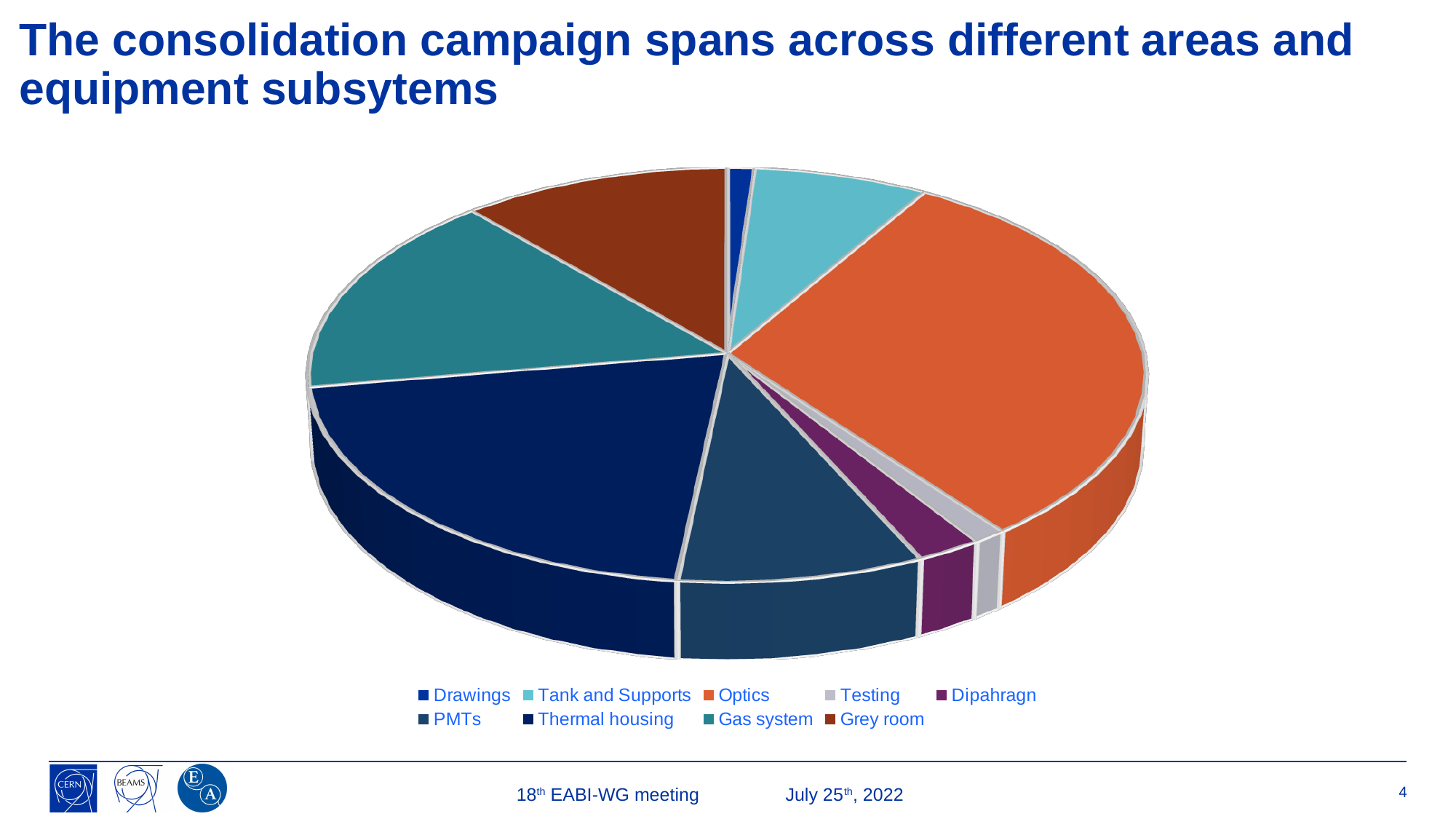
Which slice is larger, Thermal housing or PMTs? Thermal housing Which slice is larger, Optics or Grey room? Optics Which slice is larger, Drawings or Tank and Supports? Tank and Supports Which category has the largest slice in the pie chart? Optics What kind of chart is shown on the slide? Pie chart What is the title of the slide containing the pie chart? The consolidation campaign spans across different areas and equipment subsytems What colour is the Optics slice in the pie chart? Orange How many categories does the pie chart's legend list? 9